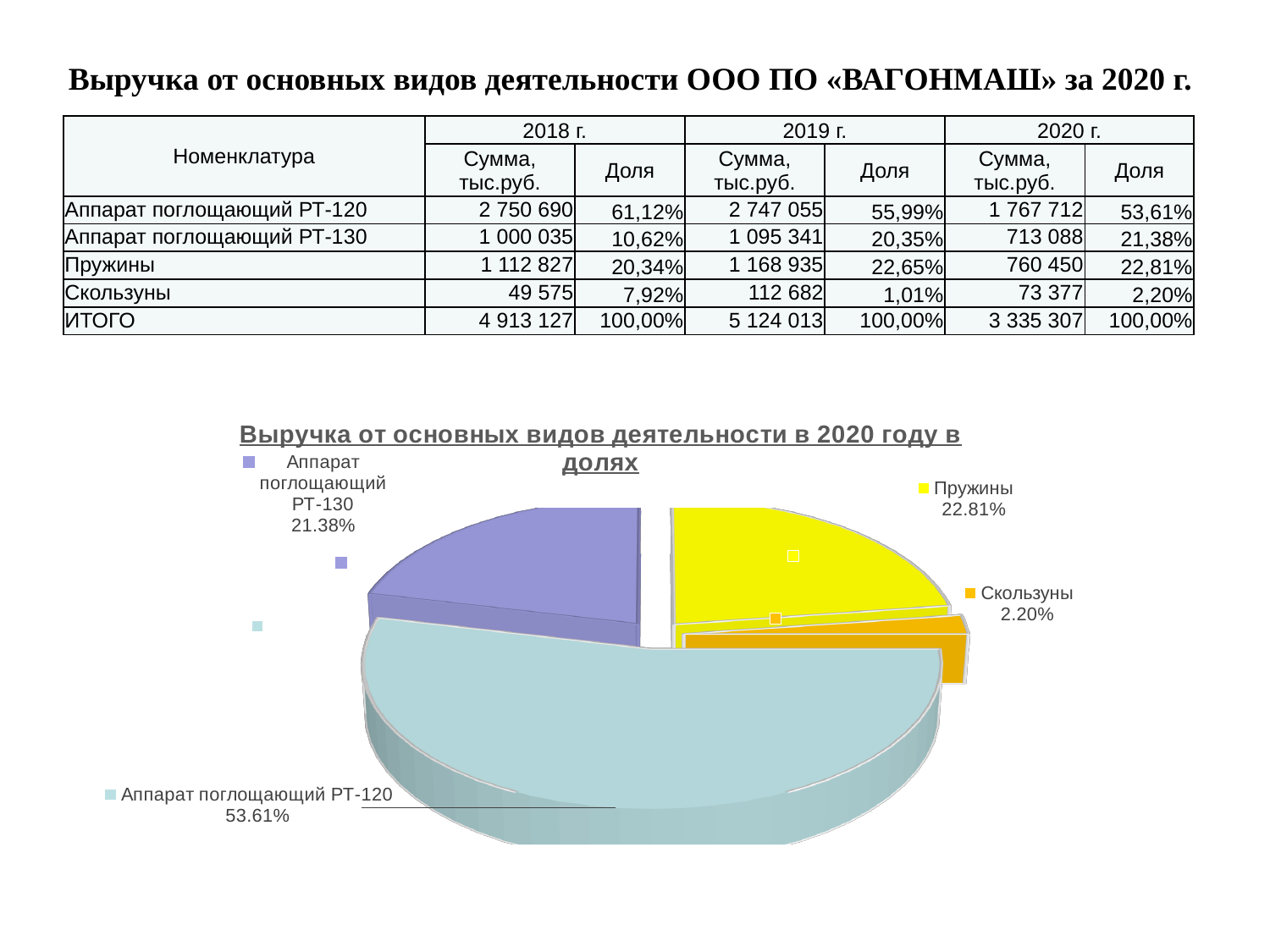
Which slice is larger: Пружины or Скользуны? Пружины What is the title of the pie chart? Выручка от основных видов деятельности в 2020 году в долях What share of the pie does Аппарат поглощающий РТ-130 have? 21.38% Which category has the largest slice of the pie? Аппарат поглощающий РТ-120 What kind of chart is shown on the slide? pie chart What colour is the Пружины slice in the pie chart? yellow What share of the pie does Пружины have? 22.81% What is the difference in percentage points between the Аппарат поглощающий РТ-120 slice and the Пружины slice? 30.80% What share of the pie does Скользуны have? 2.20% Which category has the smallest slice of the pie? Скользуны How many slices does the pie chart have? 4